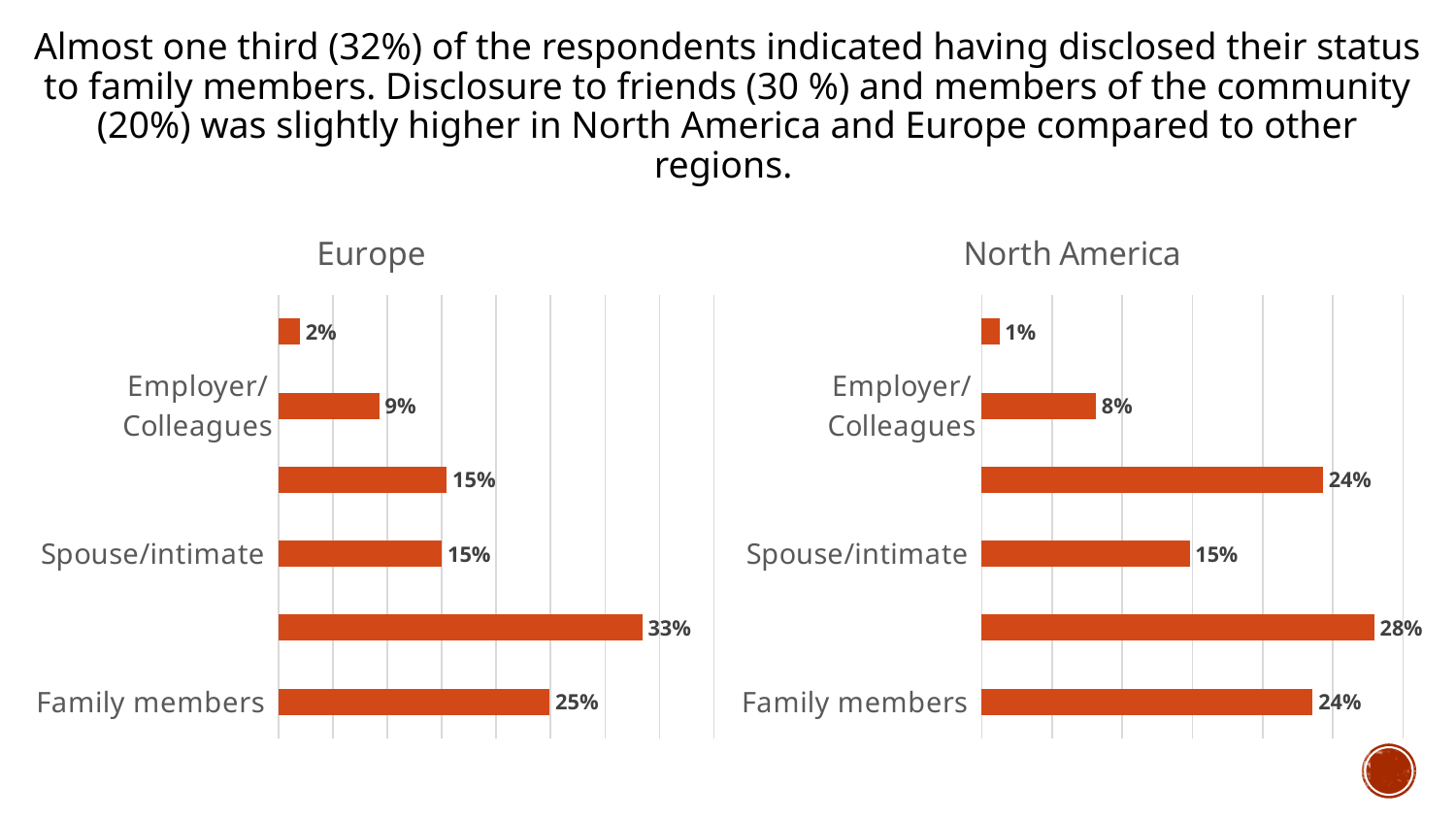
In the Europe chart, what is the value for Family members? 25% In the North America chart, what is the smallest value shown on any bar? 1% In the North America chart, what is the value for Employer/Colleagues? 8% What type of chart is the Europe chart? bar chart In the Europe chart, is the value for Spouse/intimate larger or smaller than the value for Employer/Colleagues? larger In the North America chart, what is the value for Spouse/intimate? 15% In the Europe chart, what is the difference between the values for Family members and Employer/Colleagues? 16% In the Europe chart, what is the largest value shown on any bar? 33% How many bars are plotted in the North America chart? 6 In the Europe chart, what is the value for Employer/Colleagues? 9% Which chart shows a higher value for Family members, Europe or North America? Europe In the North America chart, what is the value for Family members? 24%